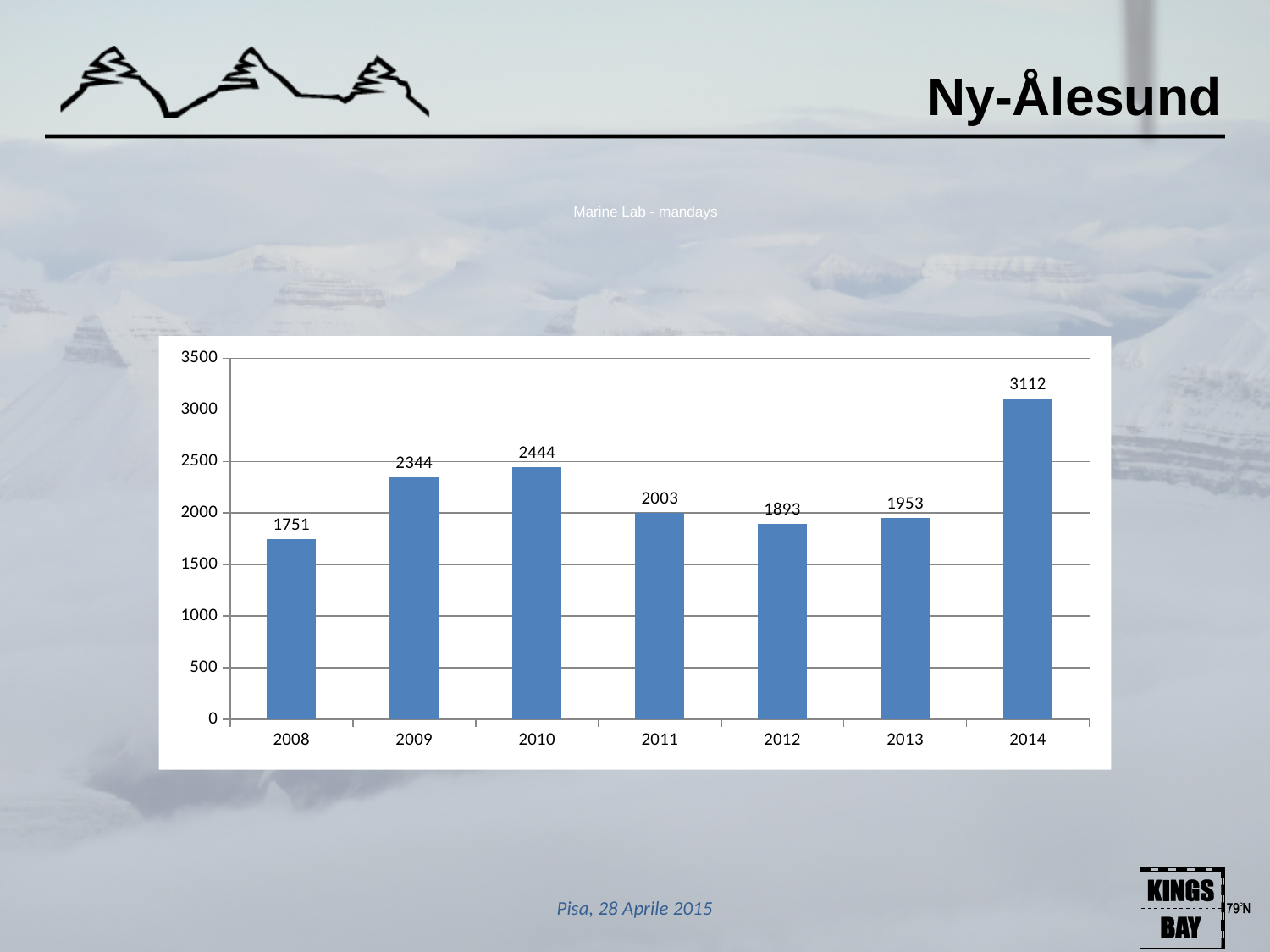
What is the title of the chart? Marine Lab - mandays Which is larger, the value for 2012 or the value for 2013? 2013 What is the difference between the values for 2014 and 2013? 1159 What is the value for 2011? 2003 How many years are shown on the x axis? 7 What is the value for 2008? 1751 Which year has the lowest value? 2008 Which year has the highest value? 2014 What kind of chart is shown on the slide? bar chart What is the difference between the values for 2010 and 2009? 100 What is the value for 2014? 3112 Is the value for 2010 greater or less than 2000? greater